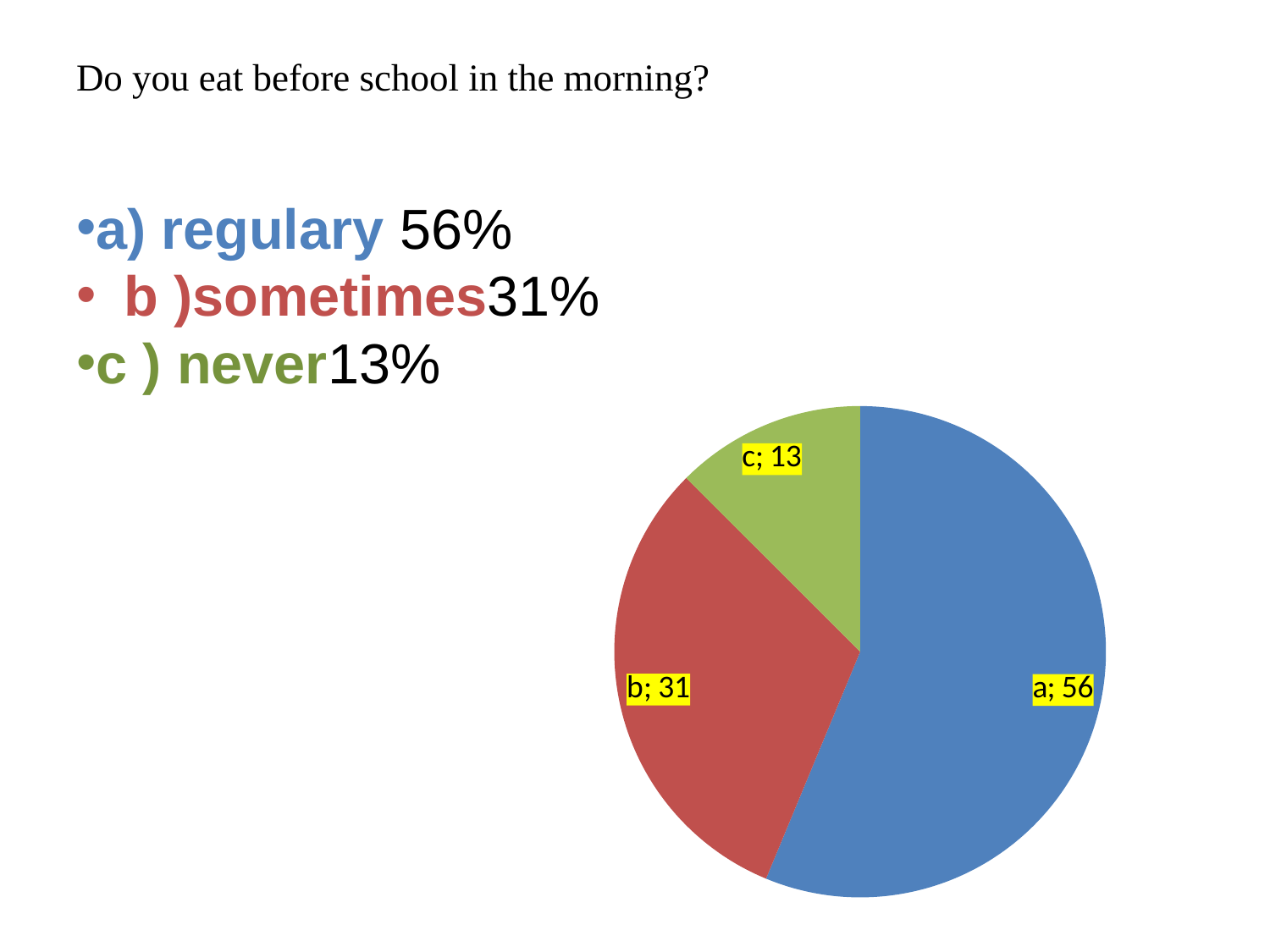
What kind of chart is shown on the slide? pie chart Which slice of the pie chart is the smallest? c What is the difference between the values for slice b and slice c? 18 How many slices does the pie chart have? 3 What is the value shown for slice b in the pie chart? 31 What is the value shown for slice c in the pie chart? 13 Which slice of the pie chart is the largest? a What colour is slice a in the pie chart? blue Which is larger, the value for slice b or the value for slice c? b What is the total of the values shown on the pie chart? 100 What is the value shown for slice a in the pie chart? 56 What is the difference between the values for slice a and slice b? 25